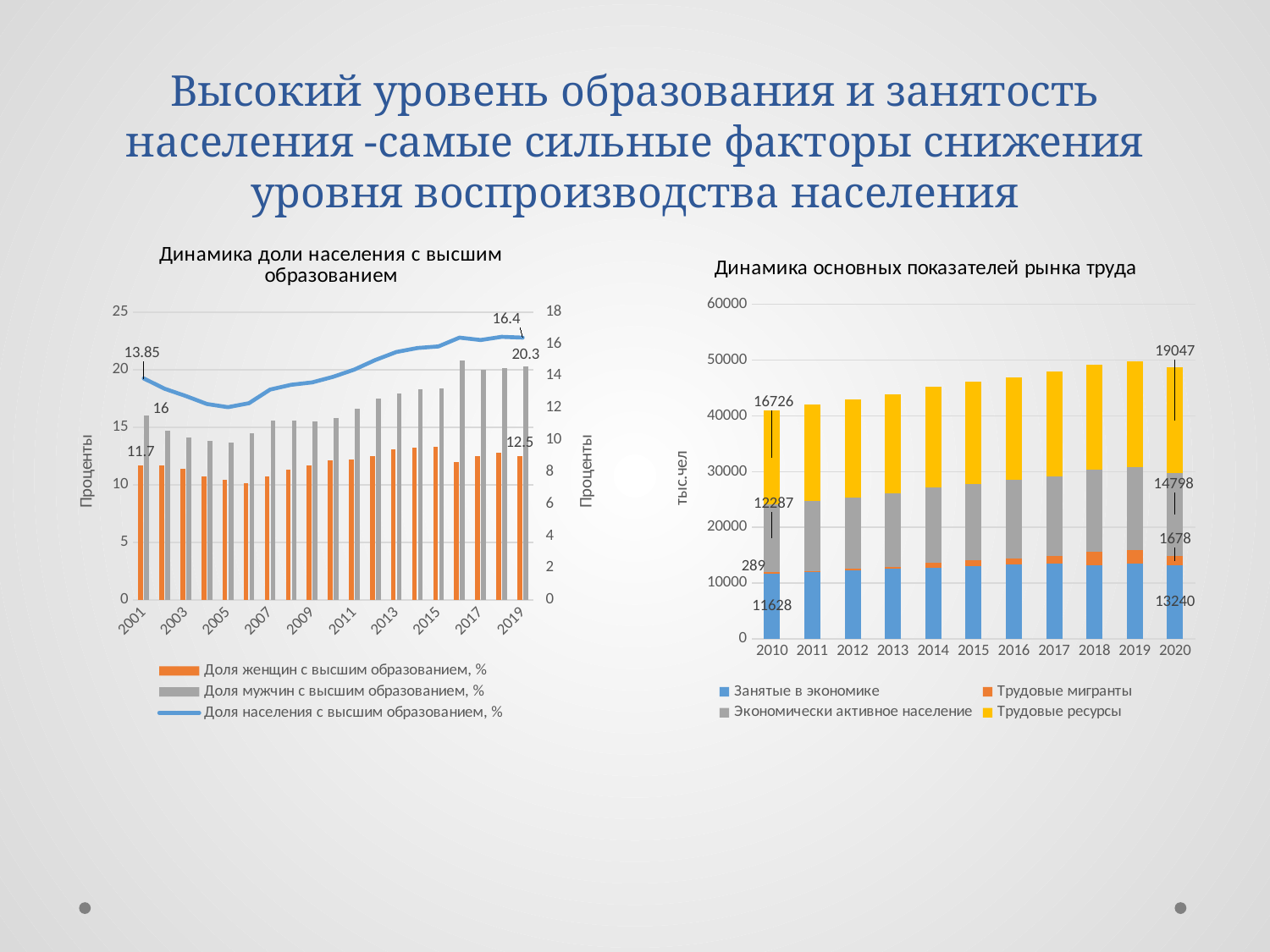
In the chart 'Динамика доли населения с высшим образованием', how many series does the legend list? 3 In the chart 'Динамика основных показателей рынка труда', how many years are shown on the x axis? 11 In the chart 'Динамика доли населения с высшим образованием', which is larger in 2001: the share of men or the share of women with higher education? Доля мужчин с высшим образованием, % In the chart 'Динамика основных показателей рынка труда', what is the value of 'Трудовые мигранты' for 2010? 289 In the chart 'Динамика основных показателей рынка труда', what is the total of the stacked bar for 2010? 40930 In the chart 'Динамика доли населения с высшим образованием', what is the value of 'Доля населения с высшим образованием, %' for 2019? 16.4 In the chart 'Динамика доли населения с высшим образованием', what is the value of 'Доля женщин с высшим образованием, %' for 2001? 11.7 In the chart 'Динамика основных показателей рынка труда', how many series does the legend list? 4 In the chart 'Динамика доли населения с высшим образованием', what is the value of 'Доля мужчин с высшим образованием, %' for 2019? 20.3 In the chart 'Динамика доли населения с высшим образованием', does the line 'Доля населения с высшим образованием, %' rise or fall overall from 2001 to 2019? rises In the chart 'Динамика основных показателей рынка труда', what is the value of 'Трудовые ресурсы' for 2020? 19047 In the chart 'Динамика доли населения с высшим образованием', what is the difference between the men's share and the women's share in 2019? 7.8